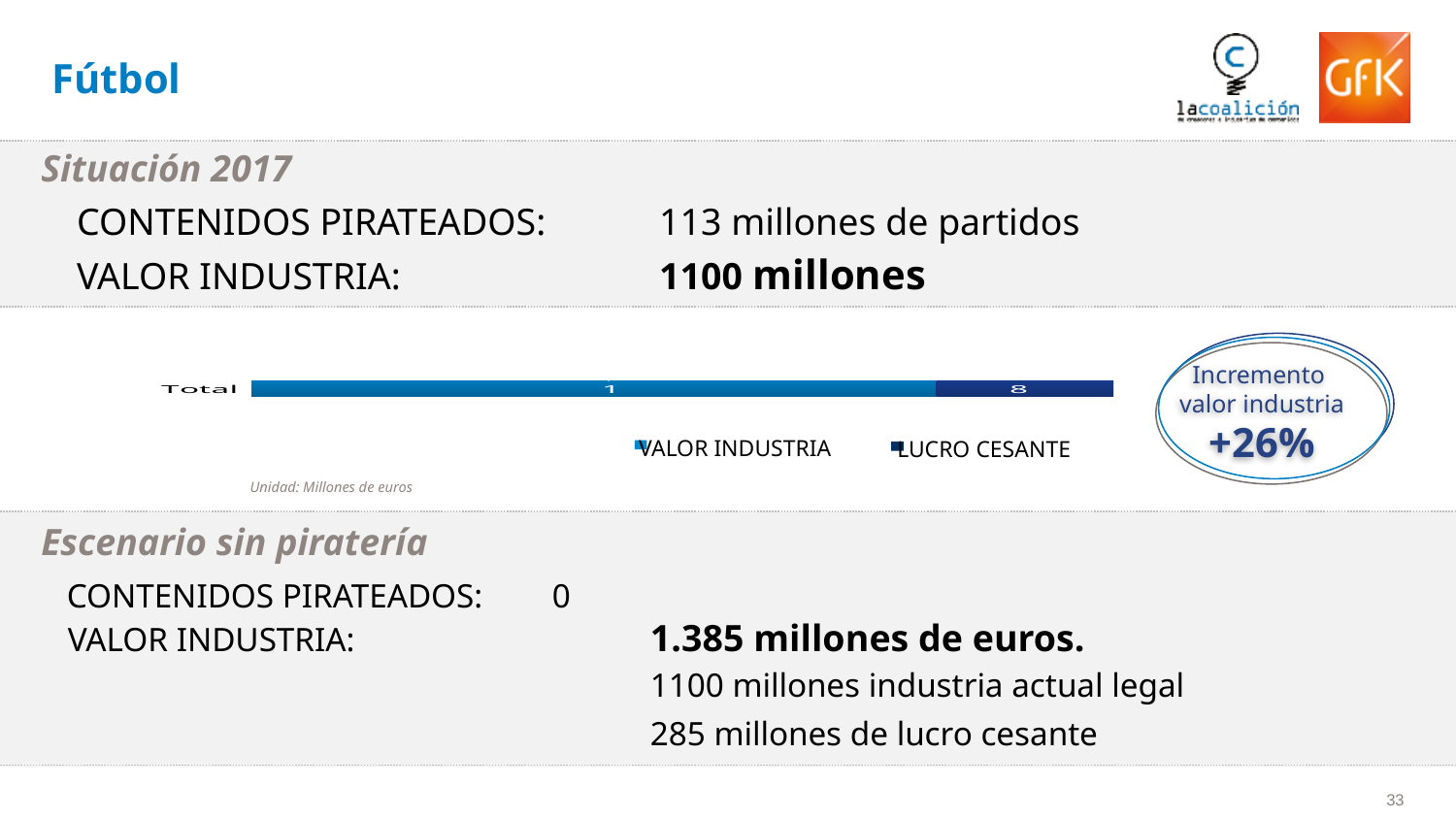
Is the chart's bar oriented horizontally or vertically? horizontally What is the label of the single category on the chart's axis? Total In the Total bar, which segment is larger: VALOR INDUSTRIA or LUCRO CESANTE? VALOR INDUSTRIA How many categories are plotted on the chart's vertical axis? 1 What are the two series named in the chart legend? VALOR INDUSTRIA and LUCRO CESANTE Which series occupies the smallest portion of the Total bar? LUCRO CESANTE What kind of chart is shown on the slide? bar chart How many series does the chart legend list? 2 Which series occupies the largest portion of the Total bar? VALOR INDUSTRIA